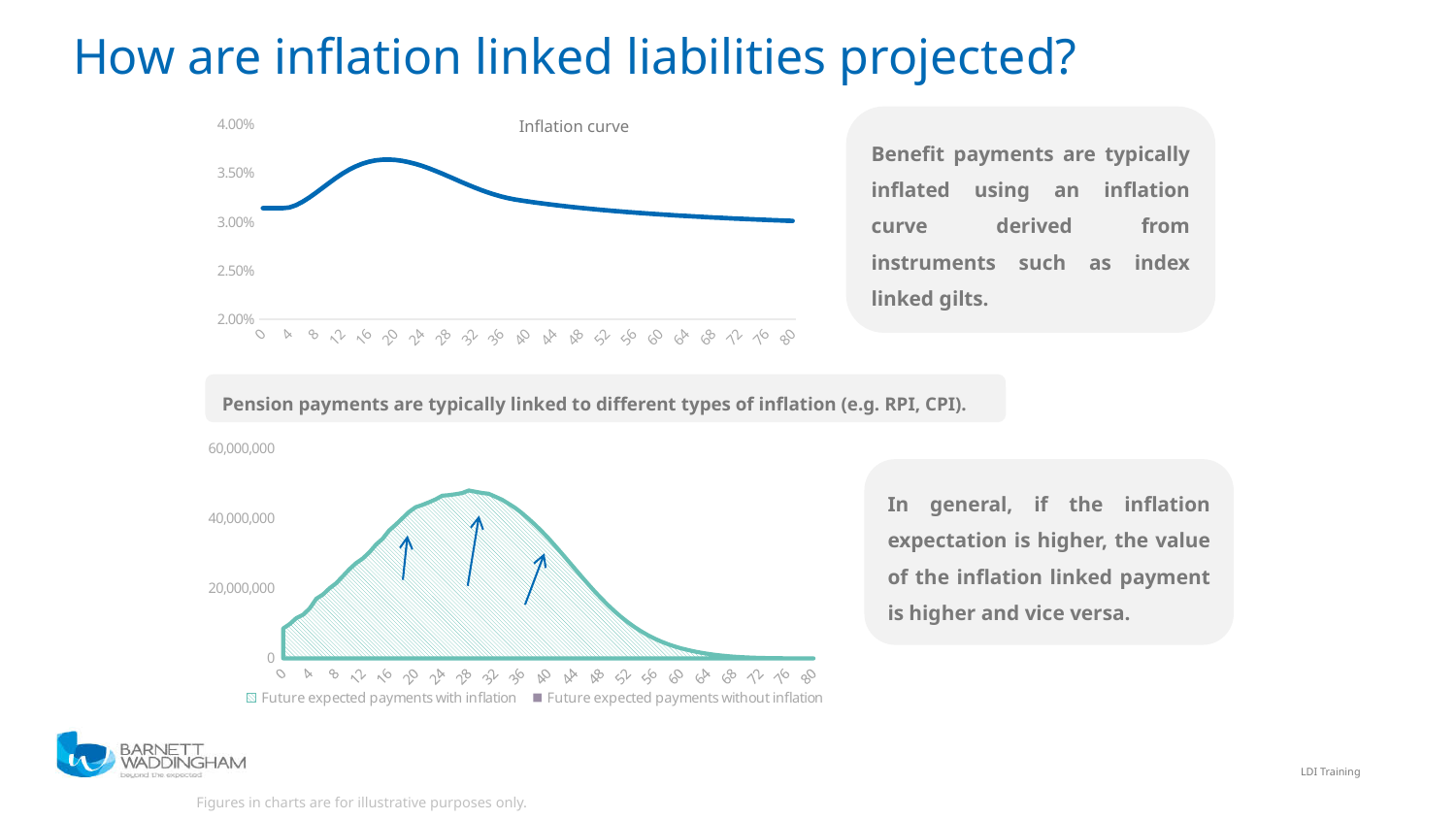
In the top 'Inflation curve' chart, does the curve rise or fall between x = 20 and x = 80? fall What type of chart is the top chart titled 'Inflation curve'? line chart What is the title of the top chart? Inflation curve In the bottom chart, is the value of future expected payments with inflation at x = 60 greater or less than 20,000,000? less How many series does the legend of the bottom chart list? 2 In the top 'Inflation curve' chart, is the value at x = 0 greater or less than 3.00%? greater In the bottom chart, is the peak value of future expected payments with inflation greater or less than 40,000,000? greater What type of chart is the bottom chart showing future expected payments? area chart In the bottom chart, do the future expected payments with inflation rise or fall between x = 28 and x = 80? fall In the bottom chart, what are the two legend entries? Future expected payments with inflation; Future expected payments without inflation